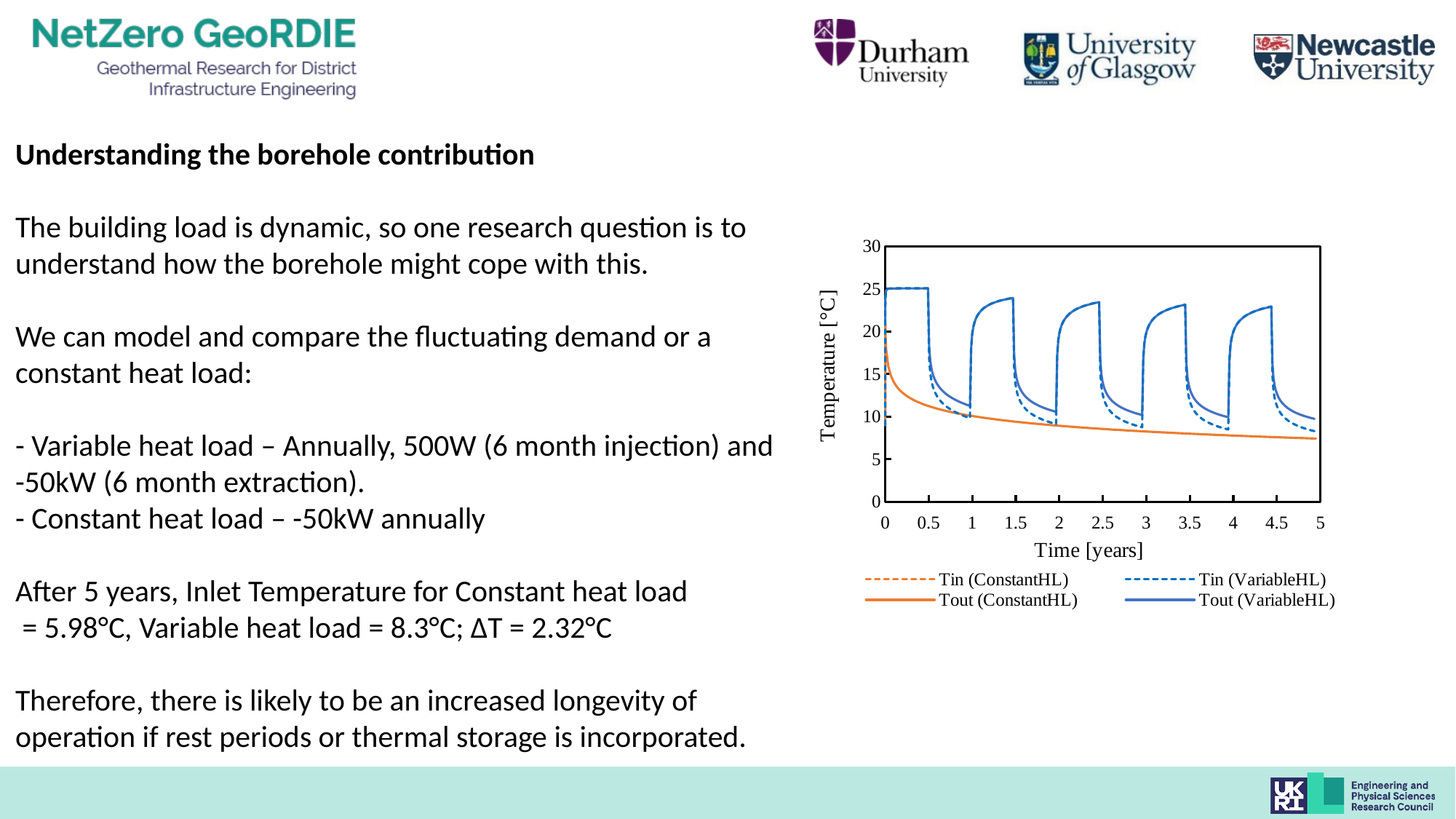
What is the maximum value shown on the x axis of the chart? 5 What is the label of the x axis of the chart? Time [years] Is the peak value of Tout (VariableHL) near 0.5 years greater or less than 20? greater At 5 years, which is higher: Tout (VariableHL) or Tout (ConstantHL)? Tout (VariableHL) What kind of chart is shown on the slide? line chart What is the maximum value shown on the y axis of the chart? 30 Is the value of Tout (ConstantHL) at 5 years greater or less than 10? less What colour are the VariableHL lines in the chart? blue Does the Tout (ConstantHL) line rise or fall over time along the x axis? fall How many series does the chart legend list? 4 Is the lowest value of Tout (VariableHL) around 4 years greater or less than 15? less